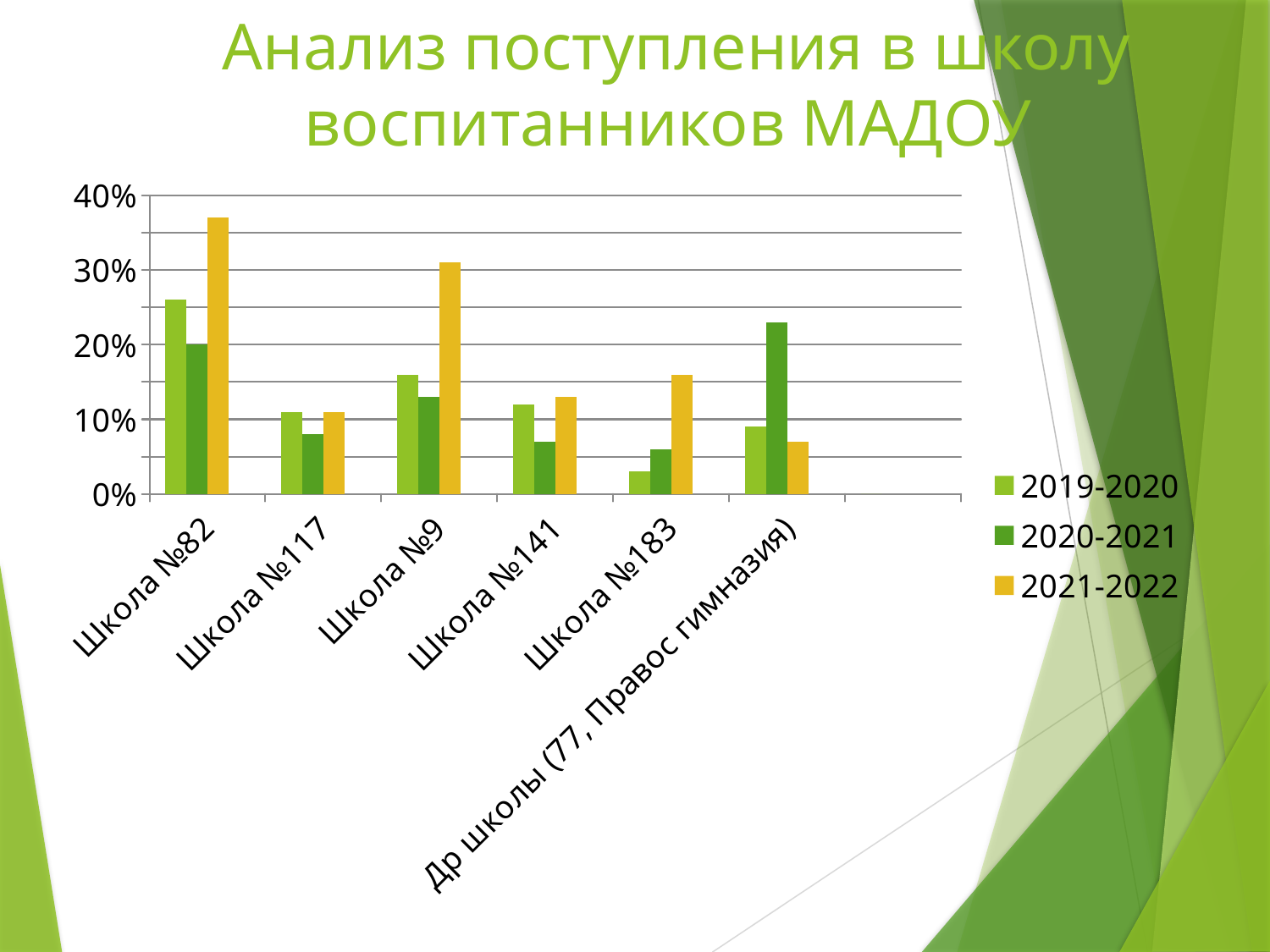
For Школа №183, which series has the larger value: 2019-2020 or 2021-2022? 2021-2022 What kind of chart is shown on the slide? Bar chart How many school categories are shown on the x axis? 6 How many series does the legend list? 3 Which school has the highest value for the 2021-2022 series? Школа №82 Which school has the lowest value for the 2019-2020 series? Школа №183 For Др школы (77, Правос гимназия), which series has the larger value: 2020-2021 or 2021-2022? 2020-2021 Is the 2019-2020 value for Школа №82 greater or less than 20%? greater Is the 2020-2021 value for Школа №141 greater or less than 10%? less Which category has the highest value for the 2020-2021 series? Др школы (77, Правос гимназия) What are the three entries listed in the legend? 2019-2020, 2020-2021, 2021-2022 Is the 2021-2022 value for Школа №9 greater or less than 20%? greater